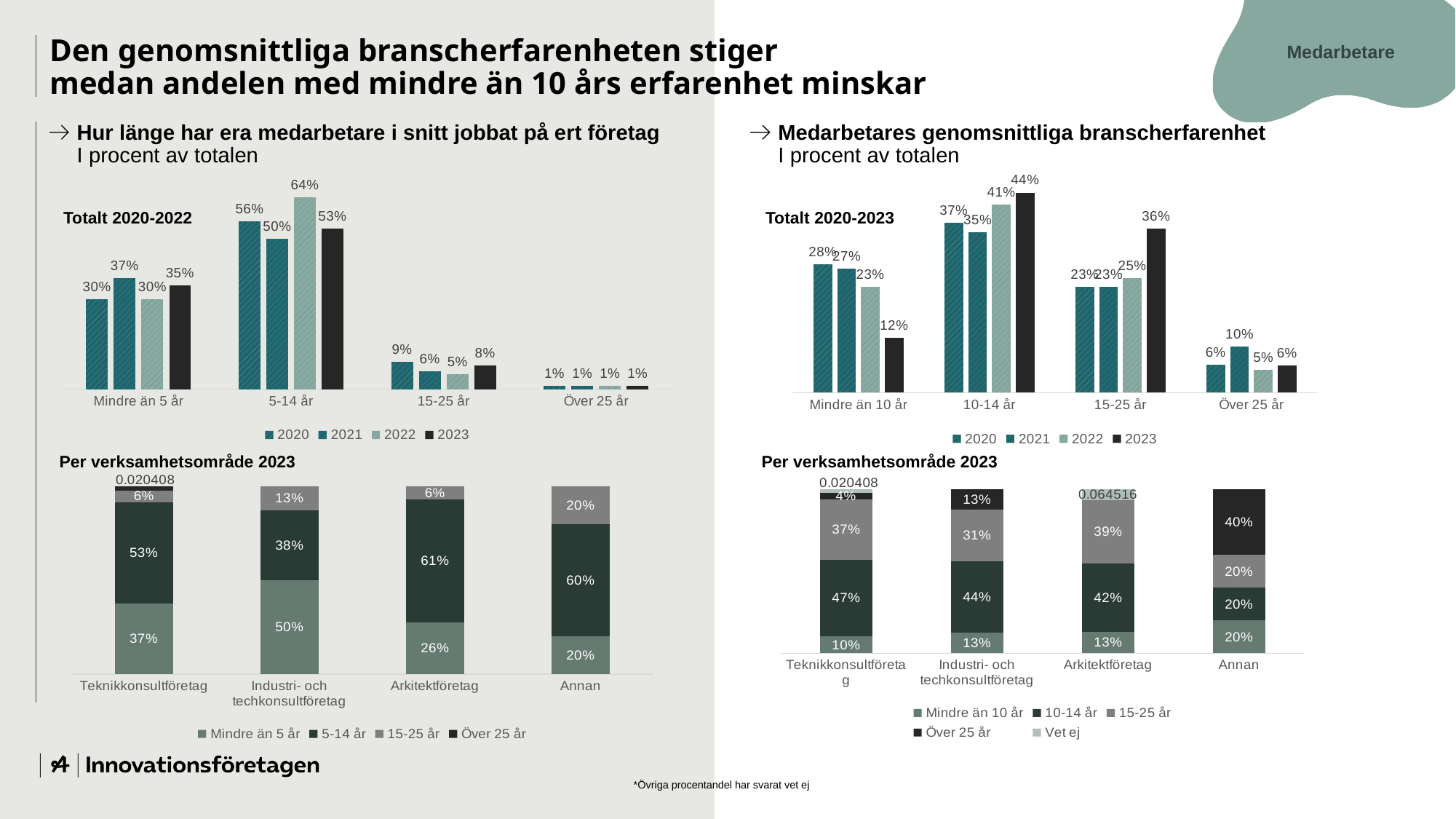
In the top-right chart (Totalt 2020-2023, average industry experience), what is the 2023 value for 'Mindre än 10 år'? 12% In the top-right chart (Totalt 2020-2023), what is the difference between the 2023 and 2020 values for '10-14 år'? 7 percentage points In the top-right chart (Totalt 2020-2023), which category has the lowest 2023 value? Över 25 år In the bottom-left stacked chart (Per verksamhetsområde 2023, left side), what is the '5-14 år' share for 'Arkitektföretag'? 61% In the top-left chart (Totalt 2020-2022), how many series does the legend list? 4 In the bottom-right stacked chart (Per verksamhetsområde 2023, right side), for 'Annan', which is larger: the 'Över 25 år' segment or the '10-14 år' segment? Över 25 år In the bottom-right stacked chart (Per verksamhetsområde 2023, right side), what is the '15-25 år' share for 'Industri- och techkonsultföretag'? 31% In the top-right chart (Totalt 2020-2023), do the values for 'Mindre än 10 år' rise or fall from 2020 to 2023? Fall In the bottom-left stacked chart (Per verksamhetsområde 2023, left side), how many categories are shown on the x axis? 4 In the top-left chart (Totalt 2020-2022), which year has the highest value for '5-14 år'? 2022 What kind of chart is the top-right chart (Totalt 2020-2023)? Bar chart In the top-left chart (Totalt 2020-2022, how long employees have worked at the company), what is the 2022 value for '5-14 år'? 64%